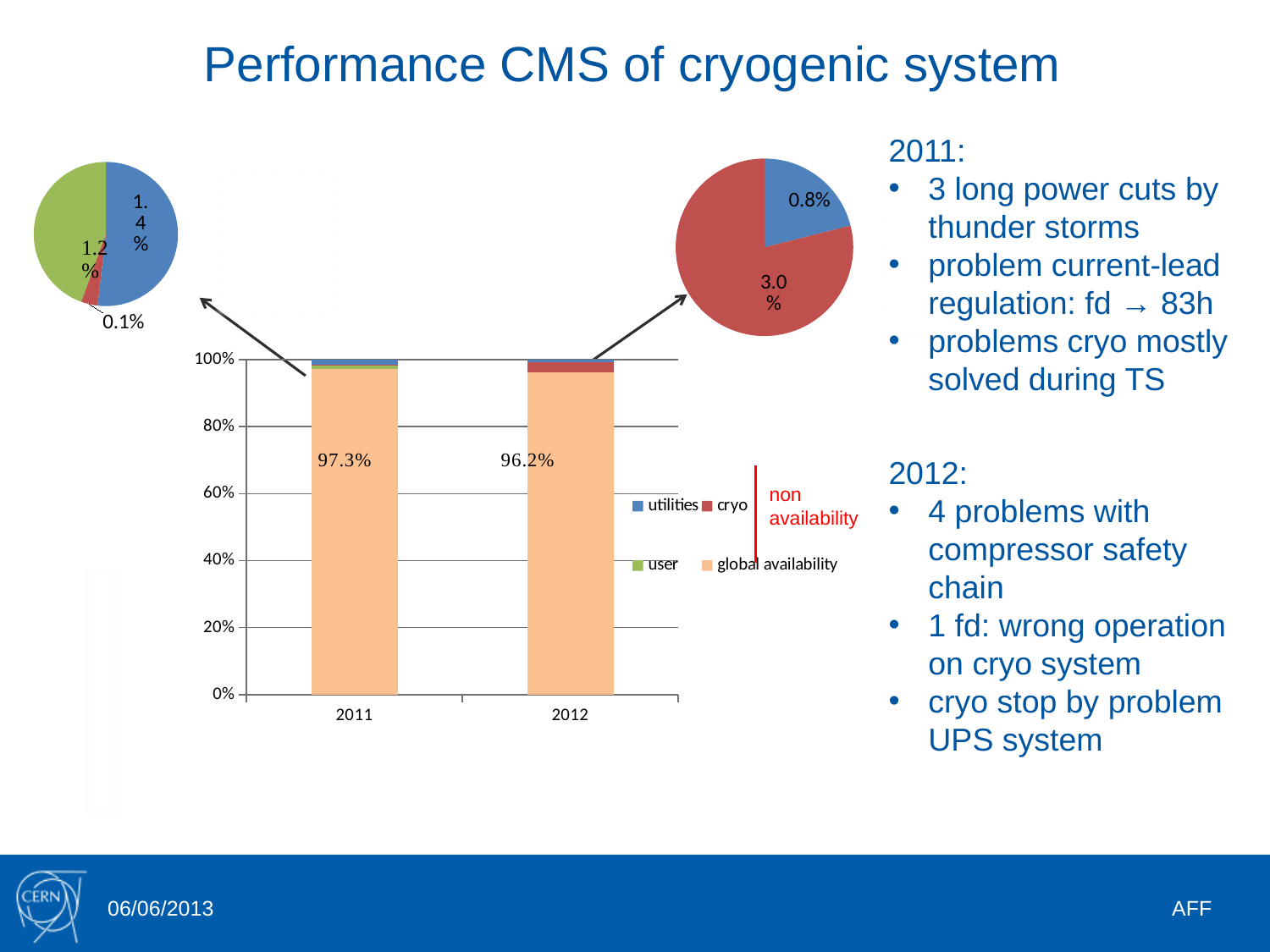
What kind of chart is the chart in the centre of the slide with the years 2011 and 2012 on the x axis? stacked bar chart How many series does the legend of the bar chart list? 4 On the bar chart, how many years are shown on the x axis? 2 On the pie chart at the top right of the slide, what is the value of the larger (red) slice? 3.0% On the pie chart at the top right of the slide, what is the value of the blue slice? 0.8% On the pie chart at the top left of the slide, what is the value of the blue slice? 1.4% On the bar chart, what is the difference between the labelled global availability for 2011 and 2012? 1.1% On the bar chart, what is the global availability value labelled for 2011? 97.3% On the bar chart, what is the global availability value labelled for 2012? 96.2% On the pie chart at the top left of the slide, what is the smallest labelled slice value? 0.1% On the bar chart, does the labelled global availability rise or fall from 2011 to 2012? fall On the bar chart, which year has the higher labelled global availability, 2011 or 2012? 2011